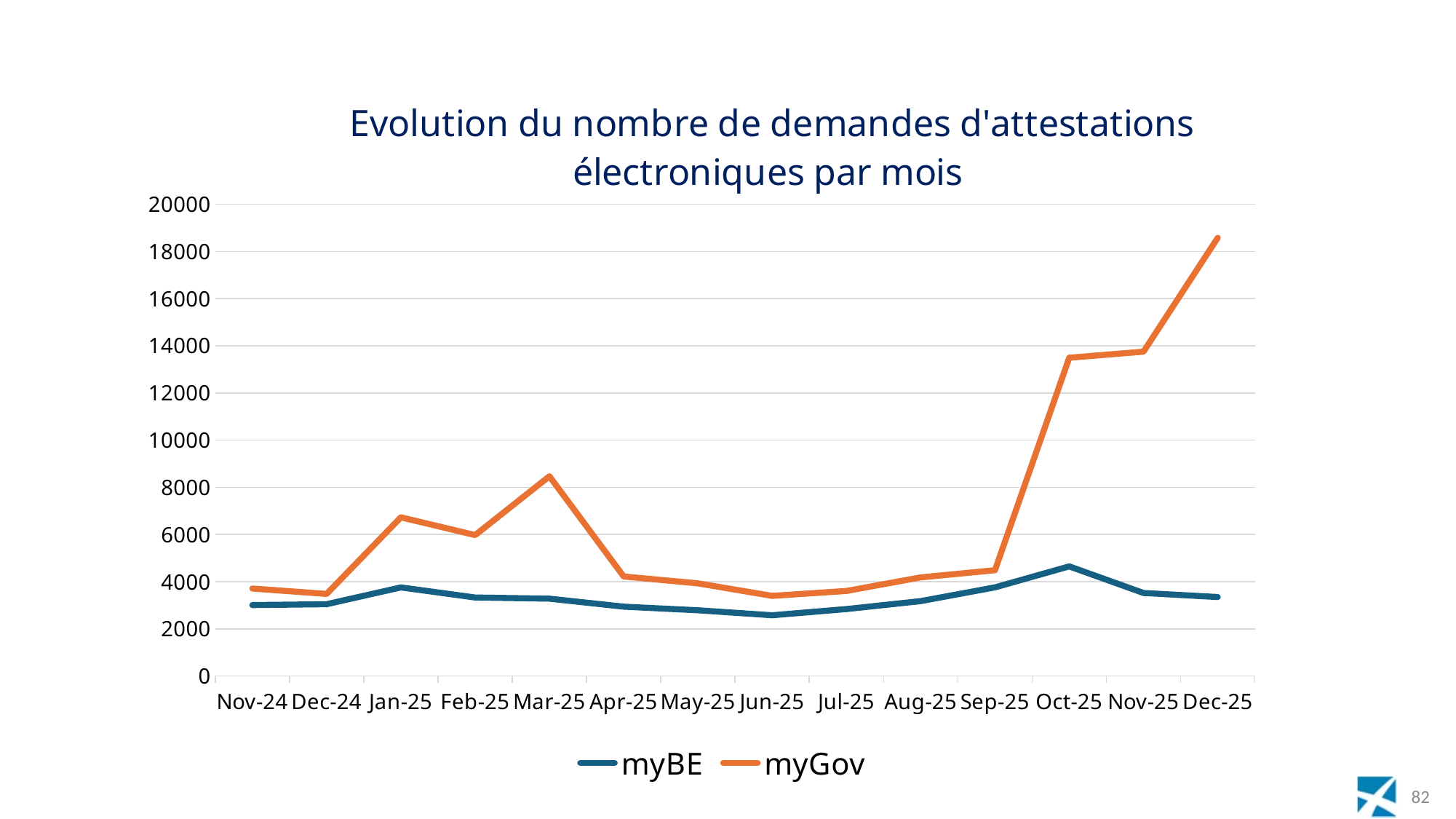
How many series does the legend list? 2 Is the value for myGov in Dec-25 greater or less than 16000? greater In Oct-25, which series has the larger value, myBE or myGov? myGov Is the value for myBE in Oct-25 greater or less than 4000? greater In which month does the myBE series reach its highest value? Oct-25 How many months are plotted along the x axis? 14 What kind of chart is shown on the slide? line chart What is the title of the chart? Evolution du nombre de demandes d'attestations électroniques par mois In which month does the myBE series reach its lowest value? Jun-25 In which month does the myGov series reach its highest value? Dec-25 Is the value for myGov in Mar-25 greater or less than 10000? less Does the myGov series rise or fall from Sep-25 to Dec-25? rise